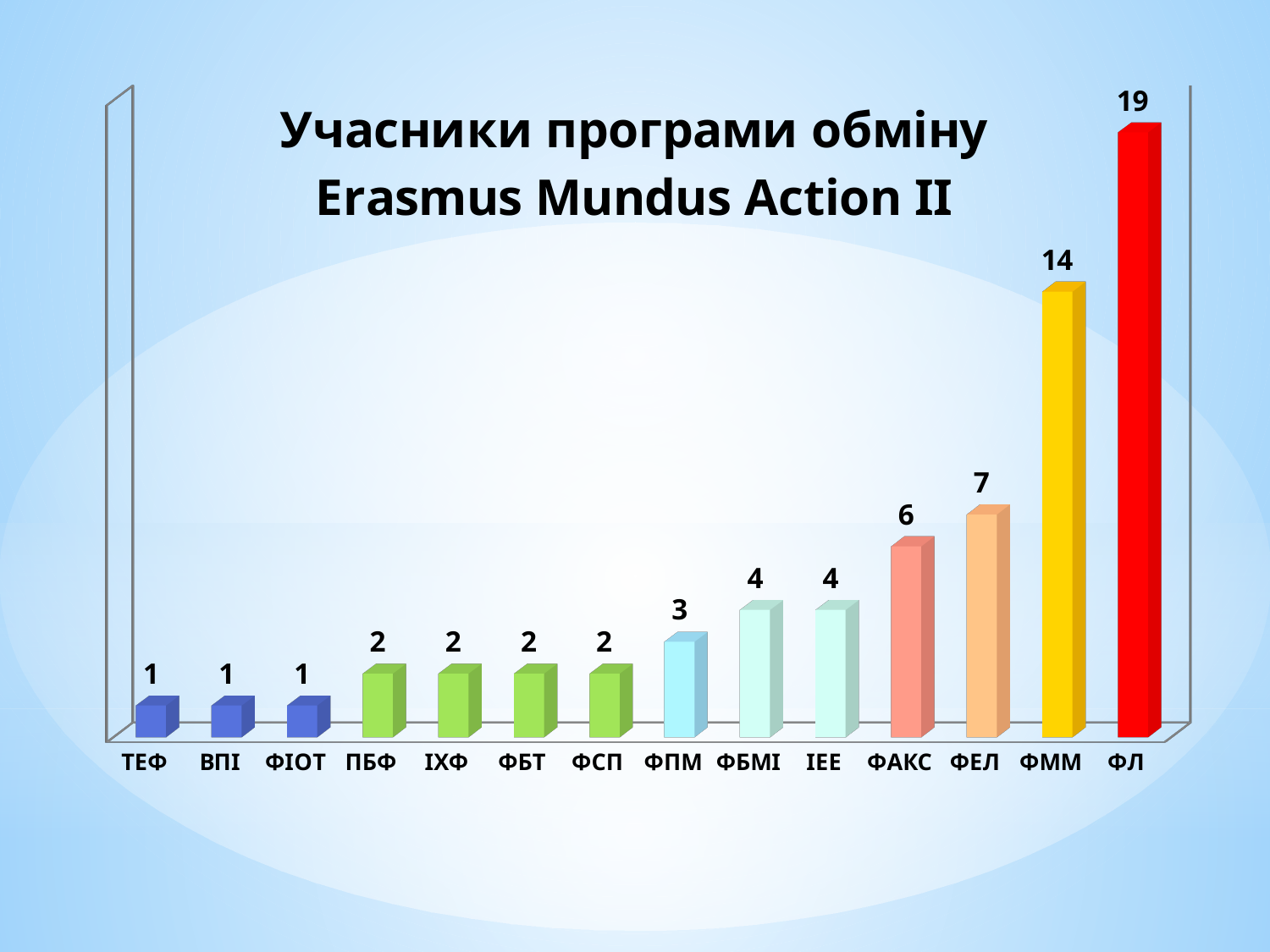
What is the value for ФЛ? 19 What is the value for ФММ? 14 What is the difference between the values for ФЛ and ФММ? 5 What is the difference between the values for ФЕЛ and ФАКС? 1 Do the values rise or fall from left to right along the x axis? rise Which category has the highest value? ФЛ How many categories are shown on the x axis? 14 What kind of chart is this? bar chart What is the title of the chart? Учасники програми обміну Erasmus Mundus Action II What is the value for ФАКС? 6 What is the value for ФПМ? 3 Which is larger, the value for ФЕЛ or the value for ФБМІ? ФЕЛ